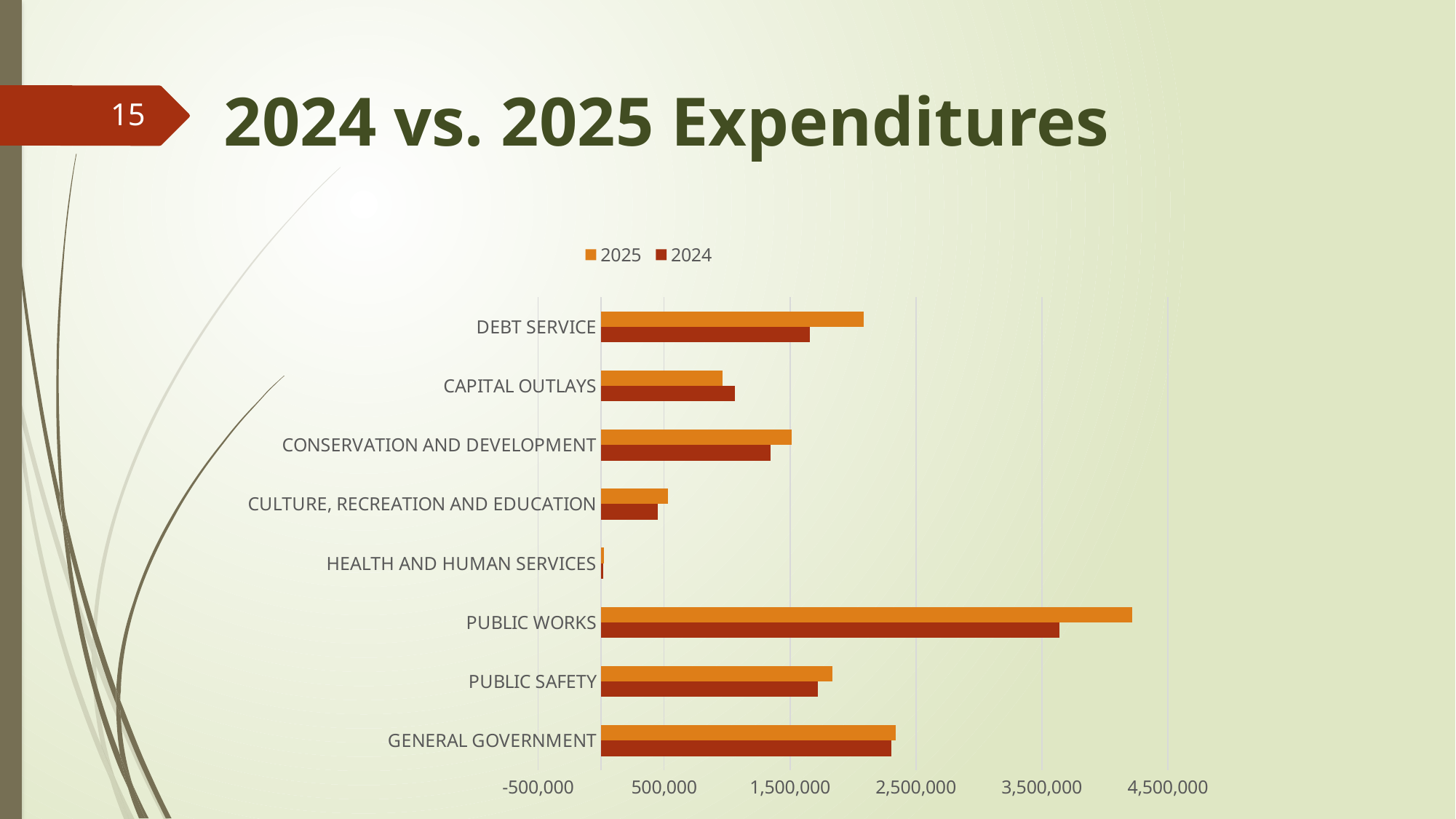
How many expenditure categories are shown on the chart? 8 Is the 2025 value for DEBT SERVICE greater or less than 1,500,000? greater What kind of chart is shown on the slide? bar chart Which category has the lowest 2024 expenditure? HEALTH AND HUMAN SERVICES Is the 2025 value for GENERAL GOVERNMENT greater or less than 2,500,000? less For DEBT SERVICE, which year has the larger expenditure, 2024 or 2025? 2025 For CAPITAL OUTLAYS, which year has the larger expenditure, 2024 or 2025? 2024 Is the 2025 value for CAPITAL OUTLAYS greater or less than 500,000? greater What is the title of the chart slide? 2024 vs. 2025 Expenditures How many series does the legend list? 2 Which category has the highest 2025 expenditure? PUBLIC WORKS